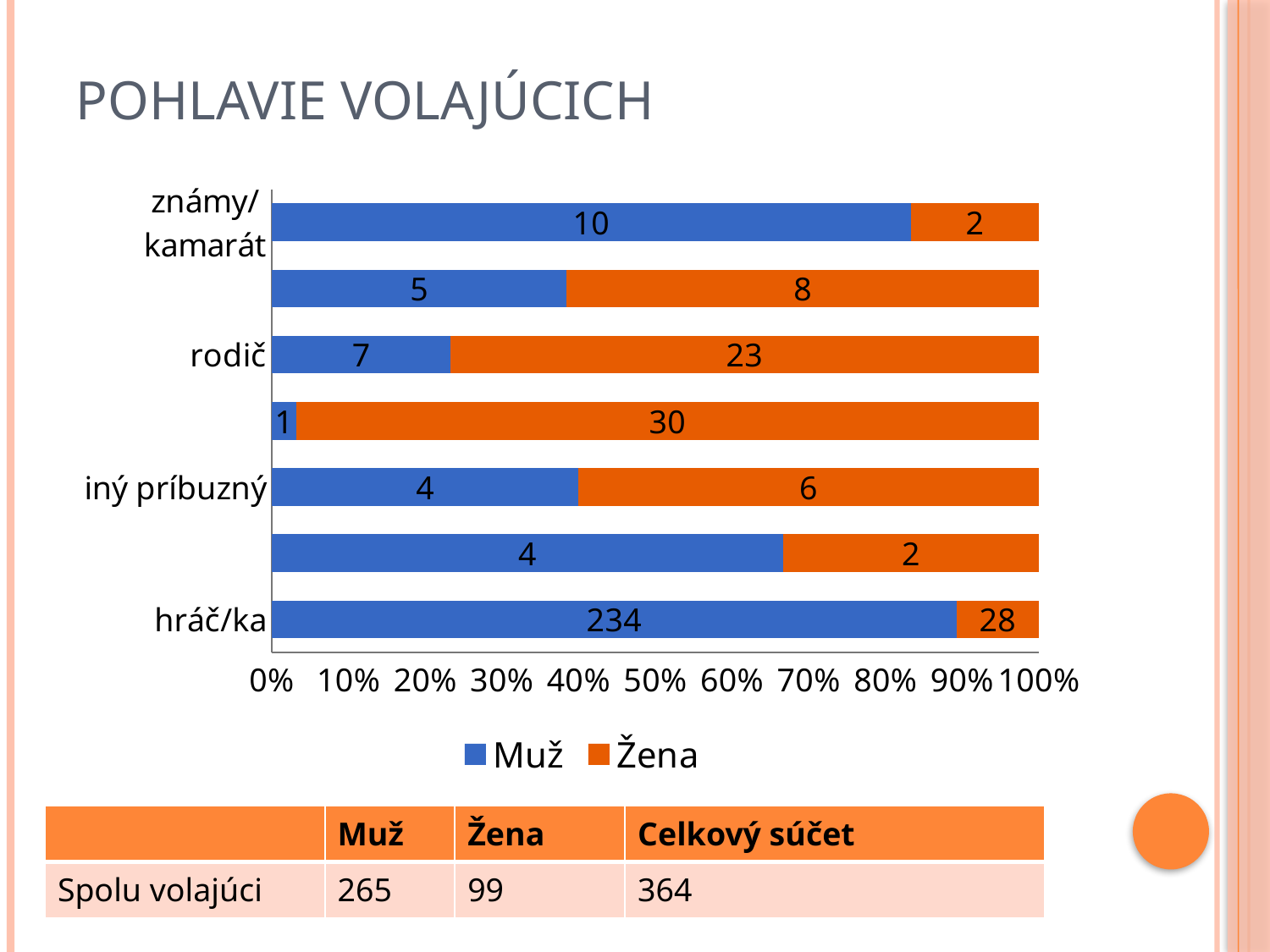
Which category has the highest Muž value? hráč/ka What is the total of the Muž and Žena values for the rodič category? 30 What is the Muž value for the hráč/ka category? 234 What are the two series named in the chart legend? Muž and Žena What type of chart is shown on the slide? Stacked bar chart How many series does the chart legend list? 2 What is the Žena value for the známy/kamarát category? 2 What is the Muž value for the iný príbuzný category? 4 For the rodič category, which is larger, the Muž value or the Žena value? Žena Is the Muž share of the hráč/ka bar greater or less than 80%? greater What is the difference between the Muž and Žena values for the hráč/ka category? 206 What is the Žena value for the rodič category? 23